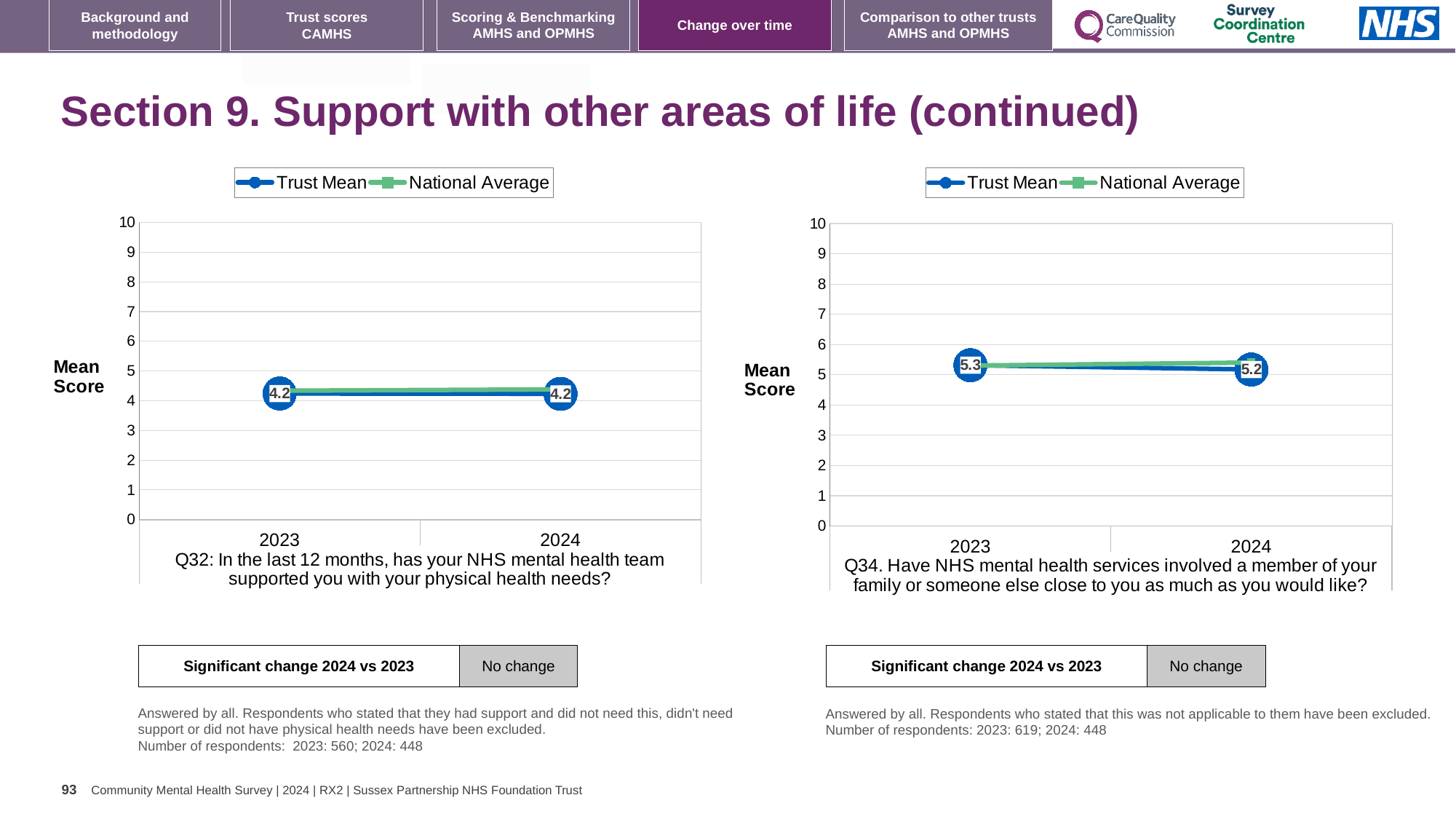
On the right chart (Q34), what is the Trust Mean score for 2023? 5.3 On the right chart (Q34), what is the Trust Mean score for 2024? 5.2 How many years are plotted on the x axis of the left chart (Q32)? 2 On the left chart (Q32), is the Trust Mean for 2024 greater or less than 5? less On the right chart (Q34), does the Trust Mean rise or fall from 2023 to 2024? fall On the left chart (Q32), what is the Trust Mean score for 2023? 4.2 What kind of chart is the left chart (Q32)? line chart On the right chart (Q34), is the Trust Mean for 2023 greater or less than 5? greater On the left chart (Q32), what is the Trust Mean score for 2024? 4.2 How many series does the legend of the right chart (Q34) list? 2 On the left chart (Q32), does the Trust Mean rise, fall or stay the same from 2023 to 2024? stay the same On the right chart (Q34), what is the difference between the Trust Mean scores for 2023 and 2024? 0.1